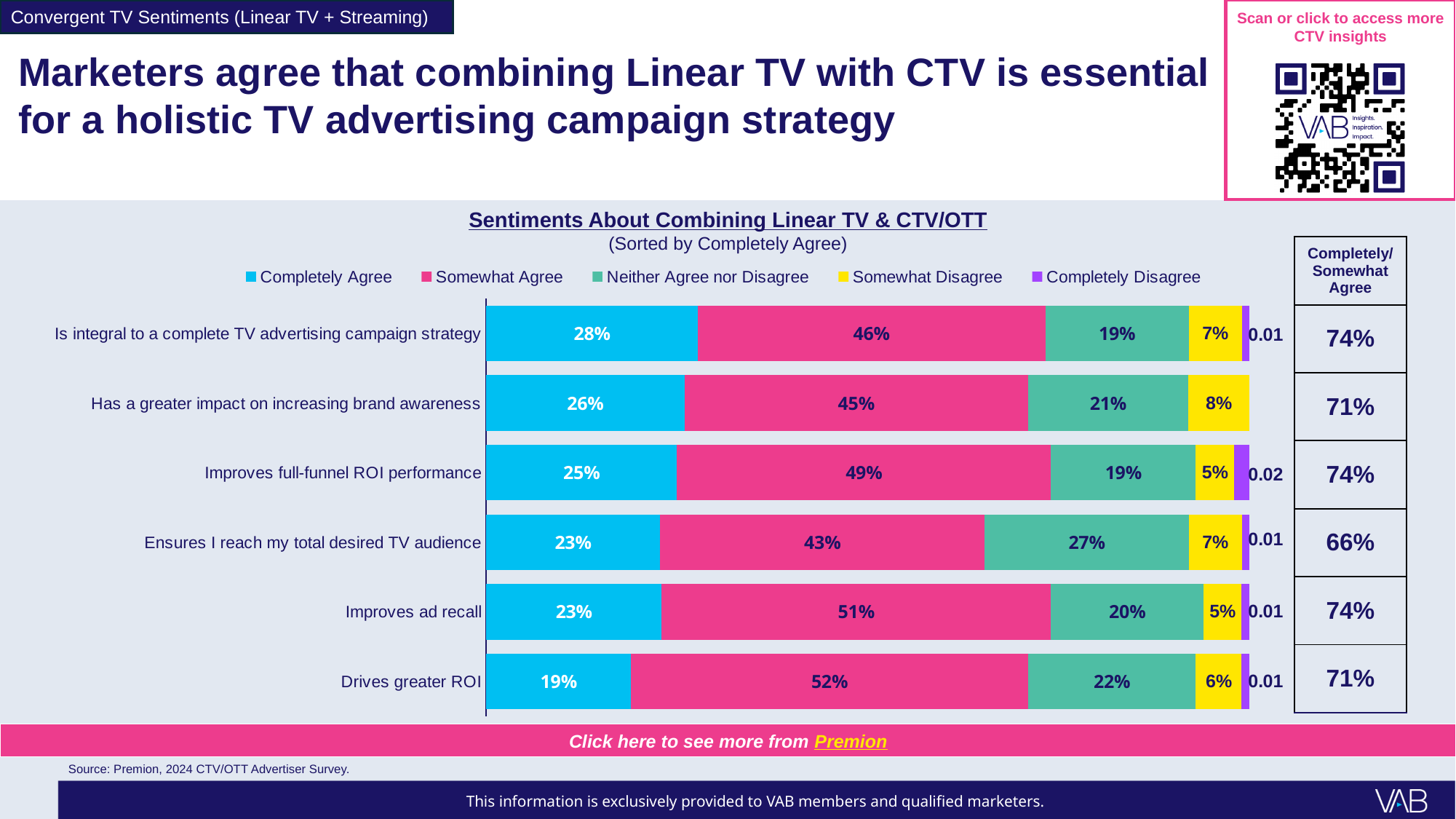
Which statement has the lowest Completely Agree value? Drives greater ROI What is the combined Completely/Somewhat Agree value shown for 'Ensures I reach my total desired TV audience'? 66% Which statement has the highest Neither Agree nor Disagree value? Ensures I reach my total desired TV audience What is the difference in Somewhat Agree values between 'Drives greater ROI' and 'Is integral to a complete TV advertising campaign strategy'? 6 percentage points Which statement has the highest Completely Agree value? Is integral to a complete TV advertising campaign strategy Which is larger: the Somewhat Disagree value for 'Has a greater impact on increasing brand awareness' or for 'Improves ad recall'? Has a greater impact on increasing brand awareness What is the Completely Agree value for 'Improves full-funnel ROI performance'? 25% What kind of chart is shown on the slide? Stacked bar chart What is the Somewhat Agree value for 'Improves ad recall'? 51% How many series does the chart legend list? 5 How many statements (categories) are plotted in the chart? 6 What is the Neither Agree nor Disagree value for 'Has a greater impact on increasing brand awareness'? 21%